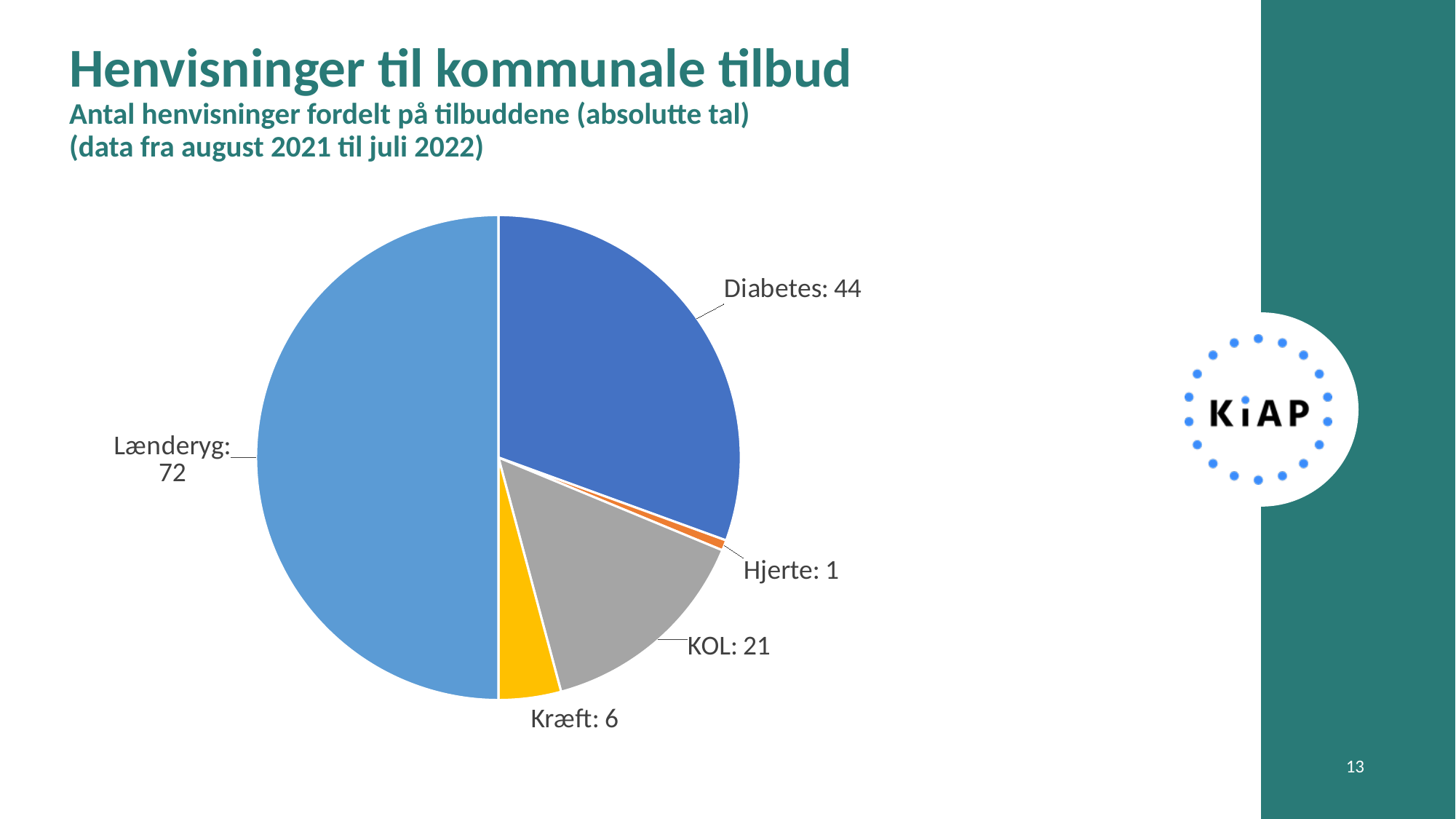
Which is larger, the value for Diabetes or the value for KOL? Diabetes How many referrals does the pie chart show for Diabetes? 44 What is the difference between the values for KOL and Kræft? 15 What is the total of all values shown in the pie chart? 144 What is the value shown for KOL in the pie chart? 21 Which category has the largest slice of the pie chart? Lænderyg Which category has the smallest slice of the pie chart? Hjerte What is the difference between the values for Lænderyg and Diabetes? 28 What is the value shown for Kræft? 6 What kind of chart is shown on the slide? Pie chart How many categories does the pie chart show? 5 What share of the pie does Lænderyg represent? 50%